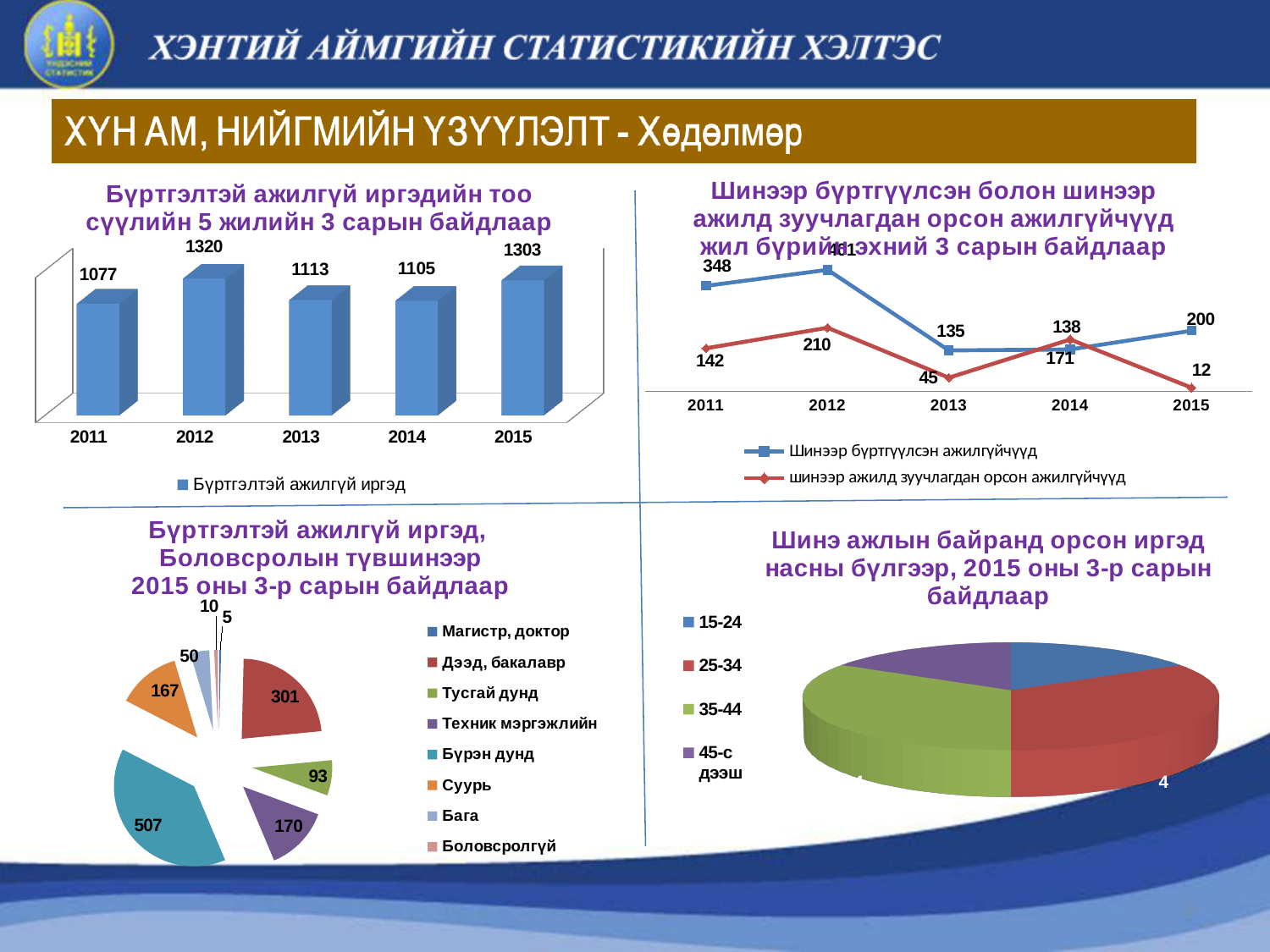
In the pie chart 'Бүртгэлтэй ажилгүй иргэд, Боловсролын түвшинээр 2015 оны 3-р сарын байдлаар', which category has the largest slice? Бүрэн дунд In the top-right line chart, how many years are plotted on the x axis? 5 How many categories does the legend of the pie chart 'Шинэ ажлын байранд орсон иргэд насны бүлгээр, 2015 оны 3-р сарын байдлаар' list? 4 In the pie chart 'Бүртгэлтэй ажилгүй иргэд, Боловсролын түвшинээр 2015 оны 3-р сарын байдлаар', what is the value for 'Бүрэн дунд'? 507 In the chart 'Бүртгэлтэй ажилгүй иргэдийн тоо сүүлийн 5 жилийн 3 сарын байдлаар', which year has the lowest value? 2011 In the chart 'Бүртгэлтэй ажилгүй иргэдийн тоо сүүлийн 5 жилийн 3 сарын байдлаар', what is the difference between the values for 2015 and 2014? 198 In the top-right line chart, which series has the larger value in 2014? шинээр ажилд зуучлагдан орсон ажилгүйчүүд In the top-right line chart, what is the value of 'Шинээр бүртгүүлсэн ажилгүйчүүд' for 2011? 348 In the top-right line chart, what is the value of 'шинээр ажилд зуучлагдан орсон ажилгүйчүүд' for 2015? 12 How many series does the legend of the top-right line chart list? 2 In the chart 'Бүртгэлтэй ажилгүй иргэдийн тоо сүүлийн 5 жилийн 3 сарын байдлаар', what is the value for 2012? 1320 What kind of chart is the top-left chart 'Бүртгэлтэй ажилгүй иргэдийн тоо сүүлийн 5 жилийн 3 сарын байдлаар'? bar chart